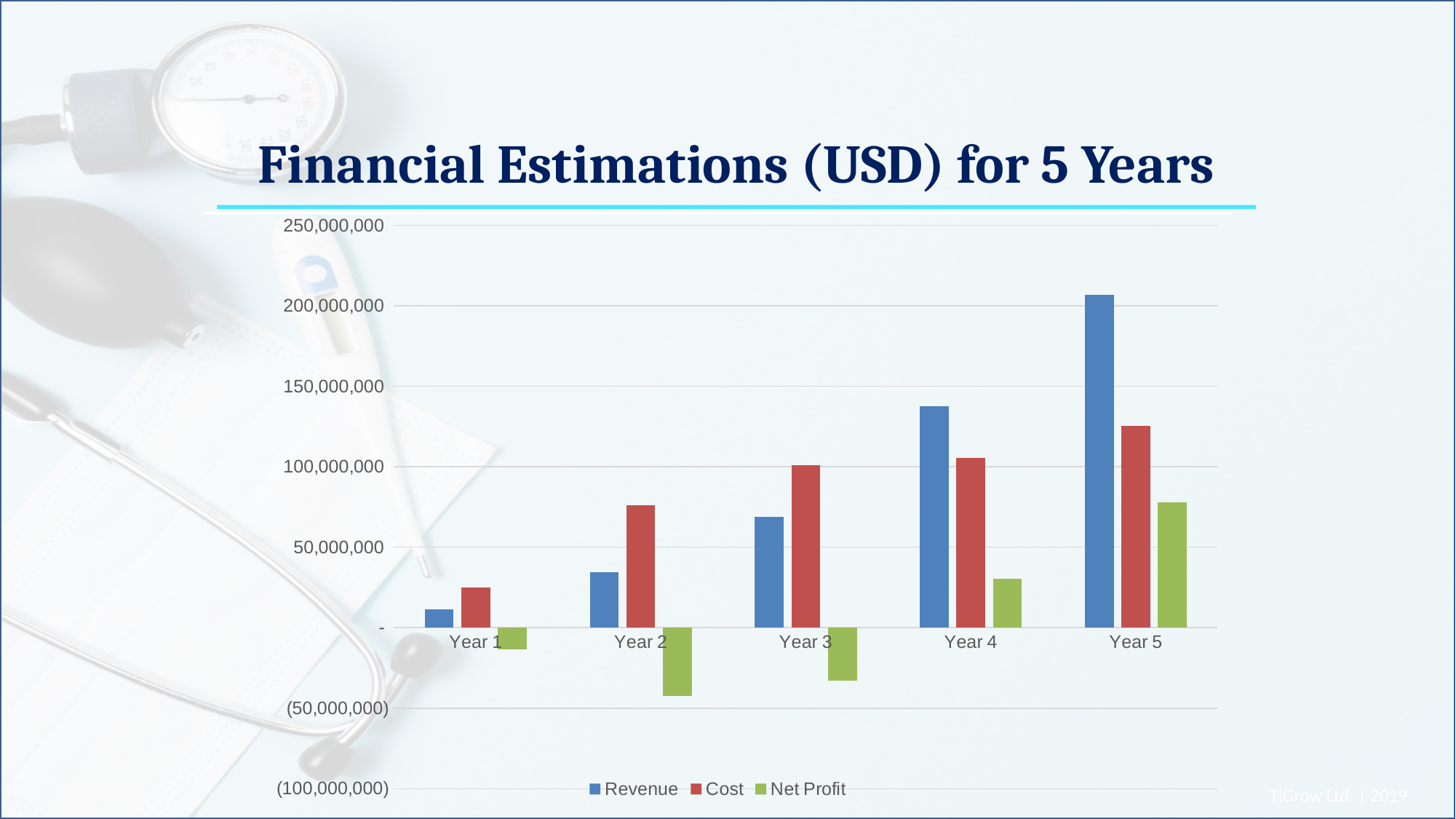
Does Revenue rise or fall from Year 1 to Year 5? Rise What kind of chart is shown on the slide? Bar chart How many years are shown on the x axis? 5 Is the Cost for Year 2 greater or less than 50,000,000? greater Is the Revenue for Year 4 greater or less than 150,000,000? less Is the Revenue for Year 5 greater or less than 200,000,000? greater In Year 4, which is larger, Revenue or Cost? Revenue How many series does the legend list? 3 Which year has the lowest Revenue? Year 1 Which year has the lowest Net Profit? Year 2 In Year 3, which is larger, Revenue or Cost? Cost Which year has the highest Revenue? Year 5